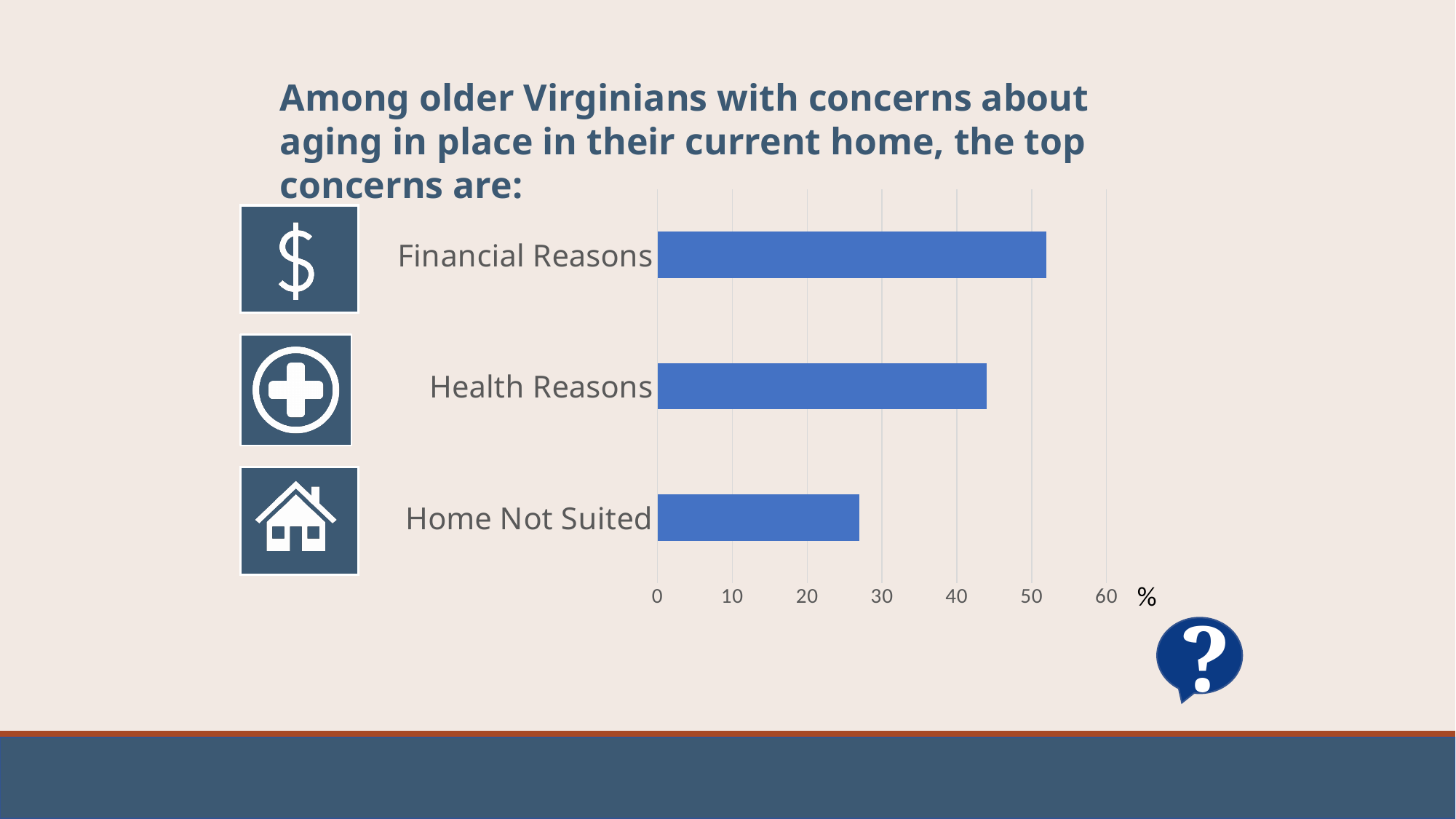
Is the value for Financial Reasons greater or less than 50? greater Is the value for Health Reasons greater or less than 40? greater How many categories are plotted in the chart? 3 What unit is shown at the end of the horizontal axis? % Which concern has the lowest value in the chart? Home Not Suited Which concern has the highest value in the chart? Financial Reasons Which is larger, the value for Financial Reasons or the value for Health Reasons? Financial Reasons Is the value for Home Not Suited greater or less than 30? less What kind of chart is shown on the slide? bar chart What is the highest tick value shown on the horizontal axis? 60 Which is larger, the value for Health Reasons or the value for Home Not Suited? Health Reasons